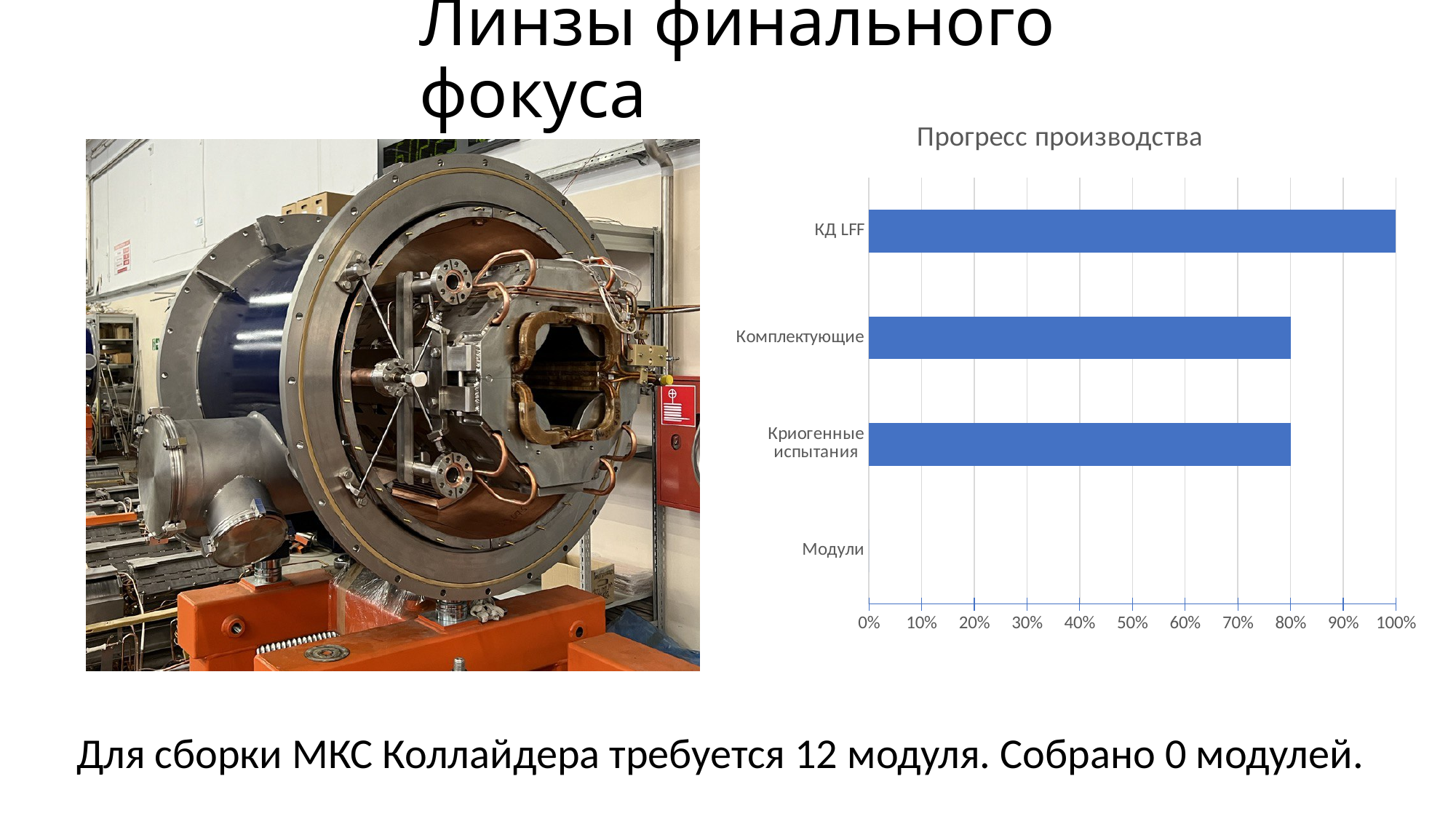
How many categories does the chart show? 4 What is the value for Комплектующие? 80% What kind of chart is shown on the slide? bar chart What is the value for КД LFF? 100% Is the value for Комплектующие greater or less than 50%? greater Which is larger, the value for КД LFF or the value for Криогенные испытания? КД LFF What is the title of the chart on the slide? Прогресс производства What is the value for Модули? 0% Which category has the highest value? КД LFF Which category has the lowest value? Модули What is the value for Криогенные испытания? 80% What is the difference between the values for КД LFF and Комплектующие? 20%